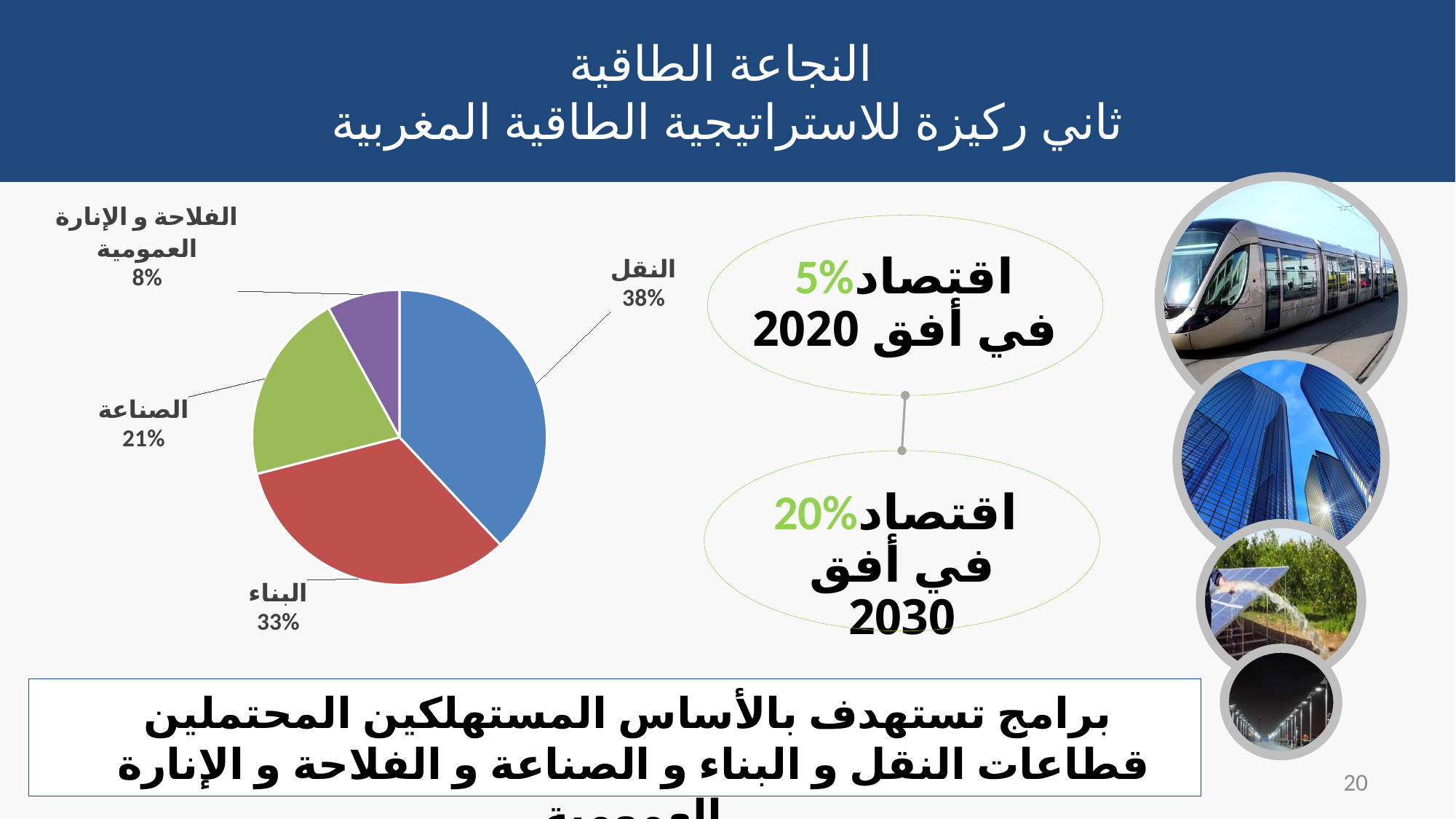
Which is larger, the share for الصناعة or the share for البناء? البناء What share of the pie does النقل (transport) hold? 38% Which sector has the smallest slice of the pie chart? الفلاحة و الإنارة العمومية What is the combined share of النقل and البناء? 71% What kind of chart is shown on the left of the slide? Pie chart What colour is the slice for النقل in the pie chart? Blue What is the difference in percentage points between النقل and البناء? 5 What share of the pie does الصناعة (industry) hold? 21% What share of the pie does الفلاحة و الإنارة العمومية (agriculture and public lighting) hold? 8% Which sector has the largest slice of the pie chart? النقل What share of the pie does البناء (construction) hold? 33% How many slices does the pie chart have? 4